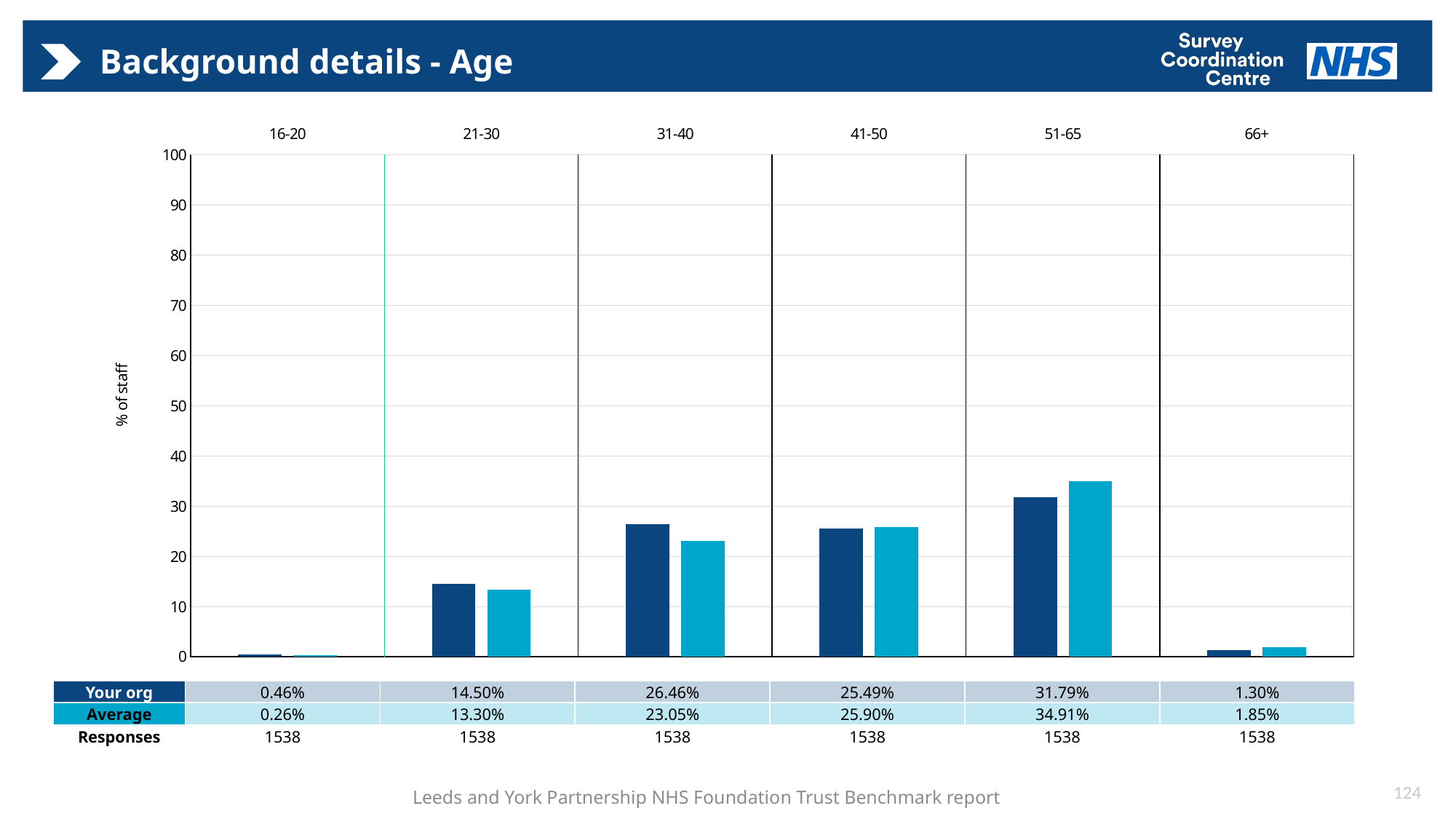
What kind of chart is shown on the slide? Bar chart How many age groups are shown on the chart? 6 How many series does the chart show? 2 What is the 'Average' value for the 51-65 age group? 34.91% What is the 'Your org' value for the 31-40 age group? 26.46% What is the number of responses shown for the 21-30 age group? 1538 What is the 'Your org' value for the 66+ age group? 1.30% Which age group has the highest 'Your org' value? 51-65 Is the 'Your org' value for the 51-65 age group greater or less than 30? greater For the 31-40 age group, which is larger: 'Your org' or 'Average'? Your org What is the difference between the 'Your org' and 'Average' values for the 51-65 age group? 3.12% Which age group has the lowest 'Average' value? 16-20